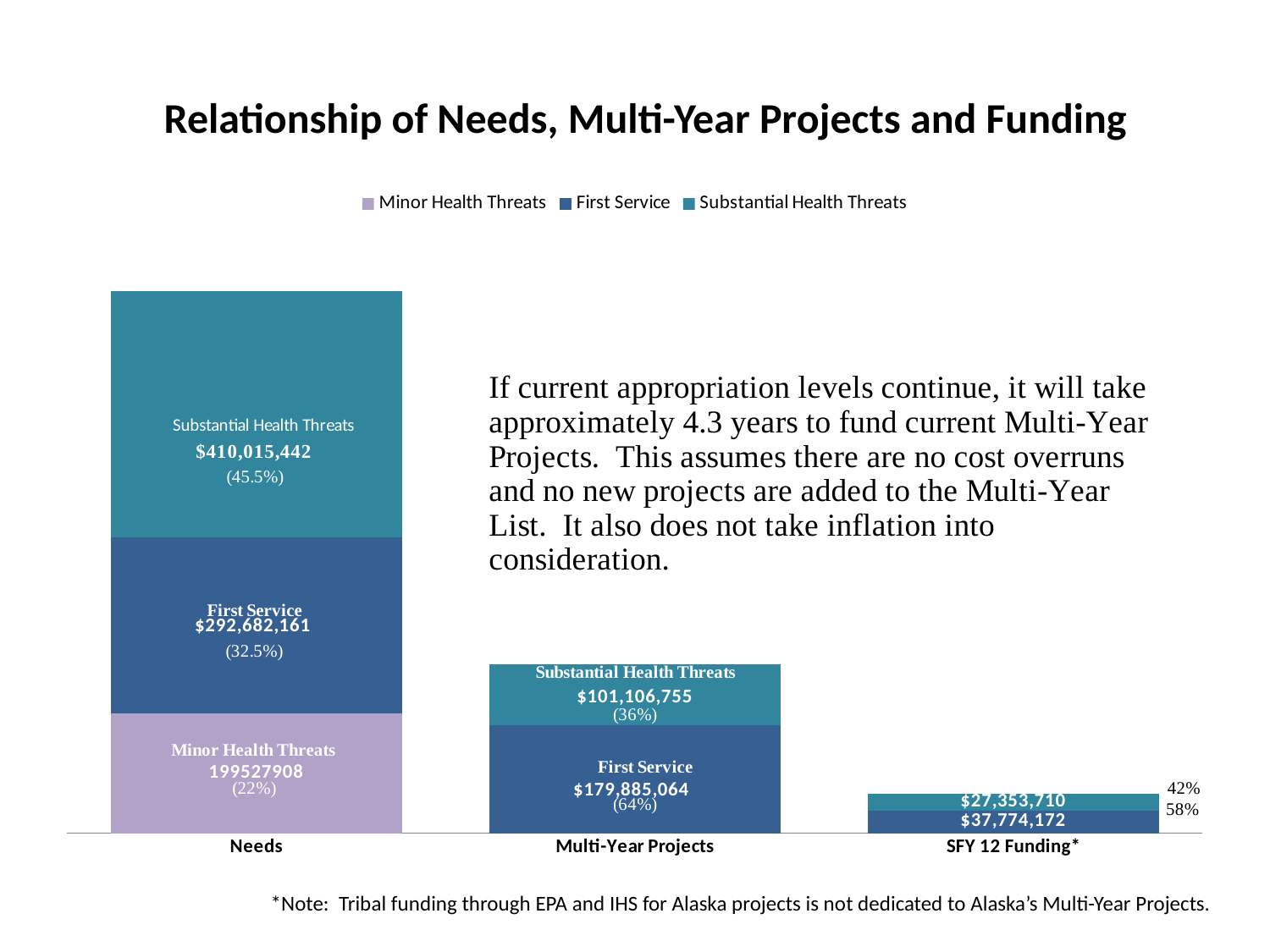
Which category has the shortest stacked bar? SFY 12 Funding* What kind of chart is shown on the slide? Stacked bar chart What is the value of First Service for Multi-Year Projects? $179,885,064 What percentage share does Substantial Health Threats make up of Multi-Year Projects? 36% What is the value of Minor Health Threats for Needs? 199527908 What is the difference between Substantial Health Threats and First Service for Needs? $117,333,281 How many categories are shown on the x axis? 3 What is the value of First Service for Needs? $292,682,161 Which category has the tallest stacked bar? Needs What is the value of Substantial Health Threats for Needs? $410,015,442 What is the total of the Multi-Year Projects stacked bar? $280,991,819 How many series does the legend list? 3